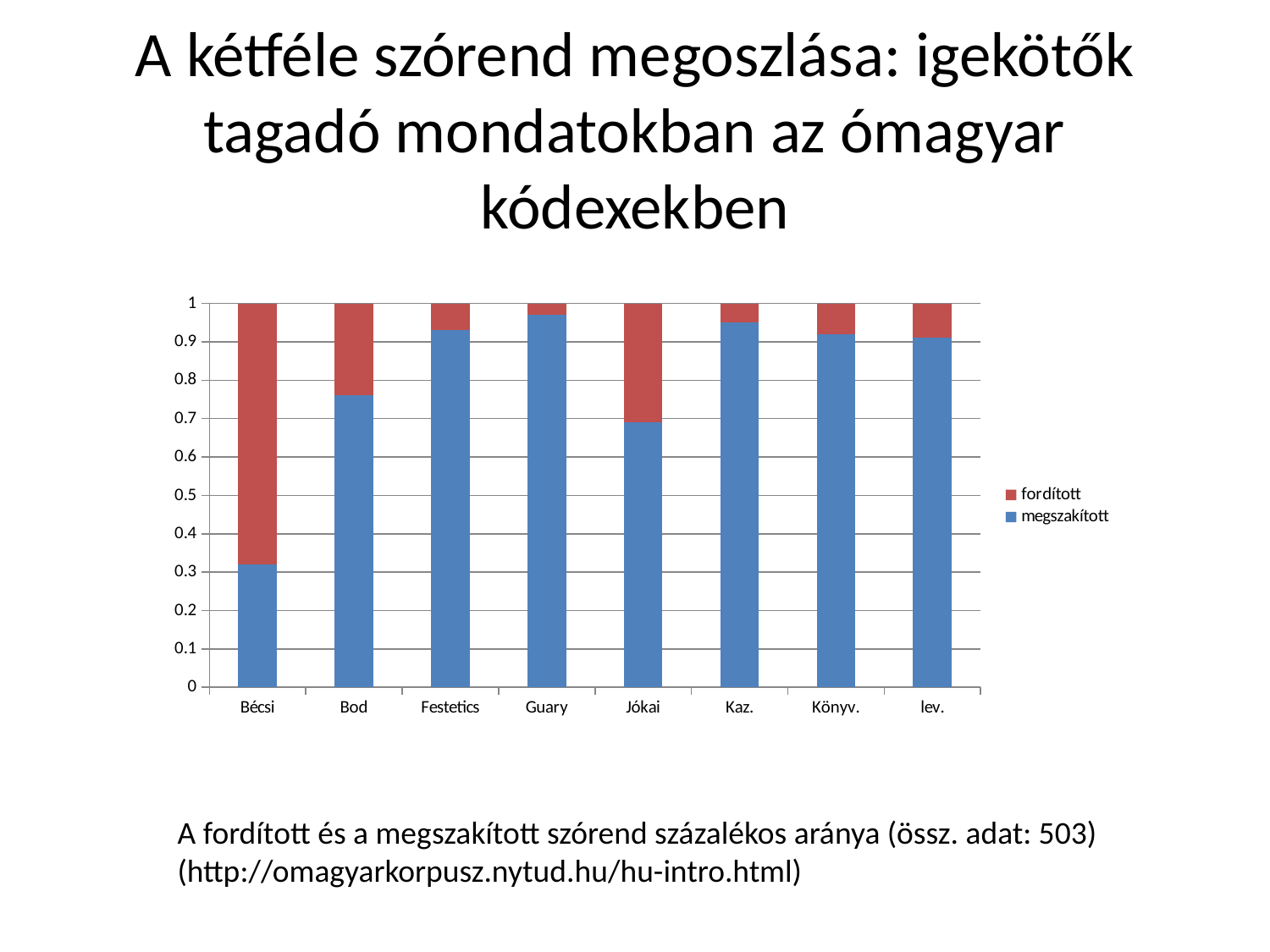
What is the total height of the stacked bar for Bécsi? 1 Which category has the lowest value for the 'megszakított' series? Bécsi Which category has the highest value for the 'fordított' series? Bécsi How many series does the chart's legend list? 2 What kind of chart is shown on the slide? Stacked bar chart Is the 'megszakított' value for Bod greater or less than 0.7? greater Which has the larger 'fordított' value, Jókai or Bod? Jókai How many codices (categories) are shown on the x axis of the chart? 8 Is the 'megszakított' value for Bécsi greater or less than 0.4? less Which has the larger 'megszakított' value, Bod or Jókai? Bod What colour represents the 'fordított' series in the chart? Red Is the 'megszakított' value for Jókai greater or less than 0.6? greater